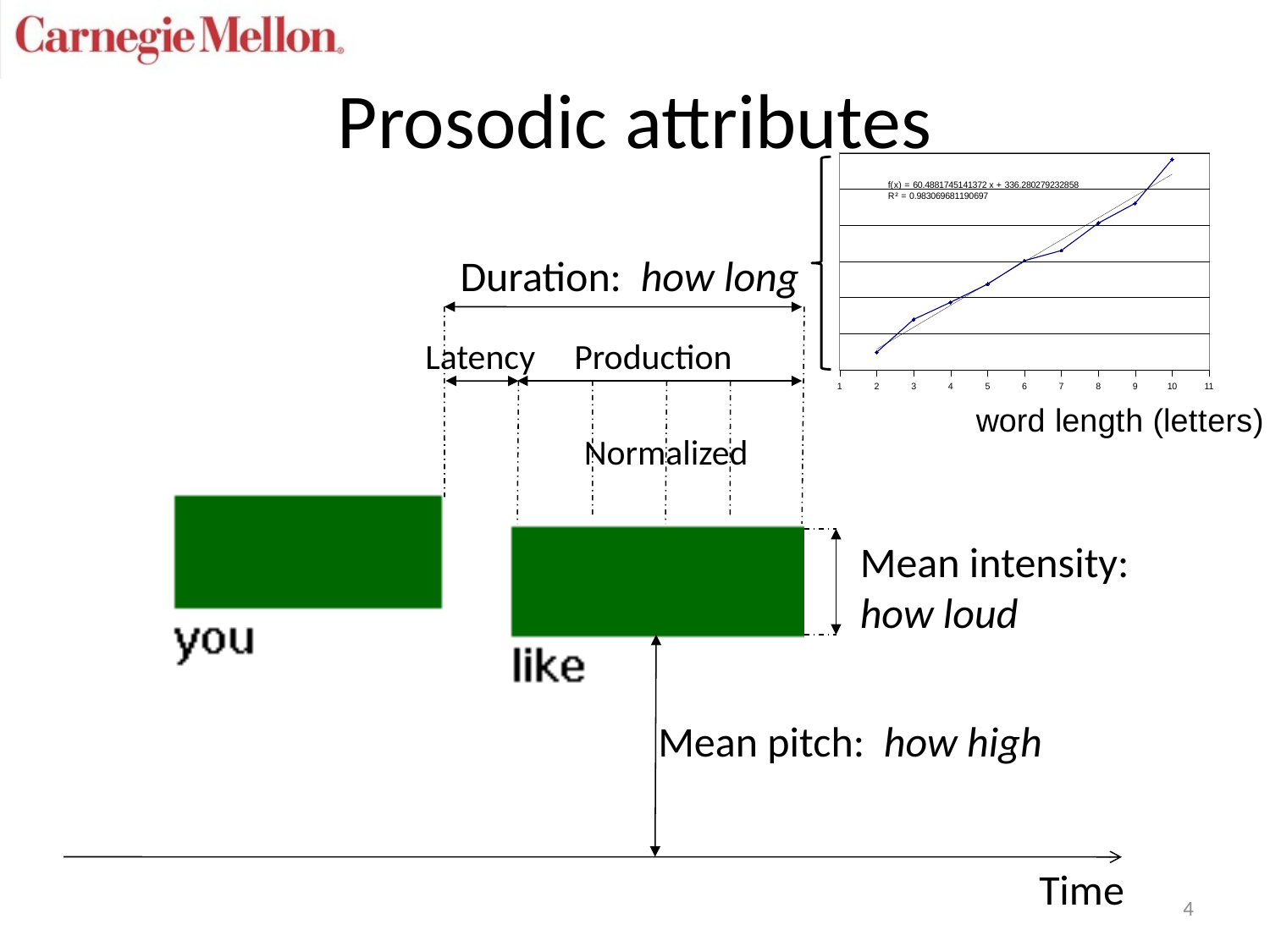
At which word length does the line chart reach its highest value? 10 What is the x-axis label of the line chart? word length (letters) What R² value is printed on the line chart? 0.983069681190697 In the line chart, do the values rise or fall as word length increases? rise At which word length does the line chart have its lowest value? 2 What kind of chart is shown in the top right of the slide? line chart In the line chart, is the value at word length 10 larger or smaller than the value at word length 2? larger In the line chart, is the value at word length 5 larger or smaller than the value at word length 8? smaller How many data points are plotted on the line chart? 9